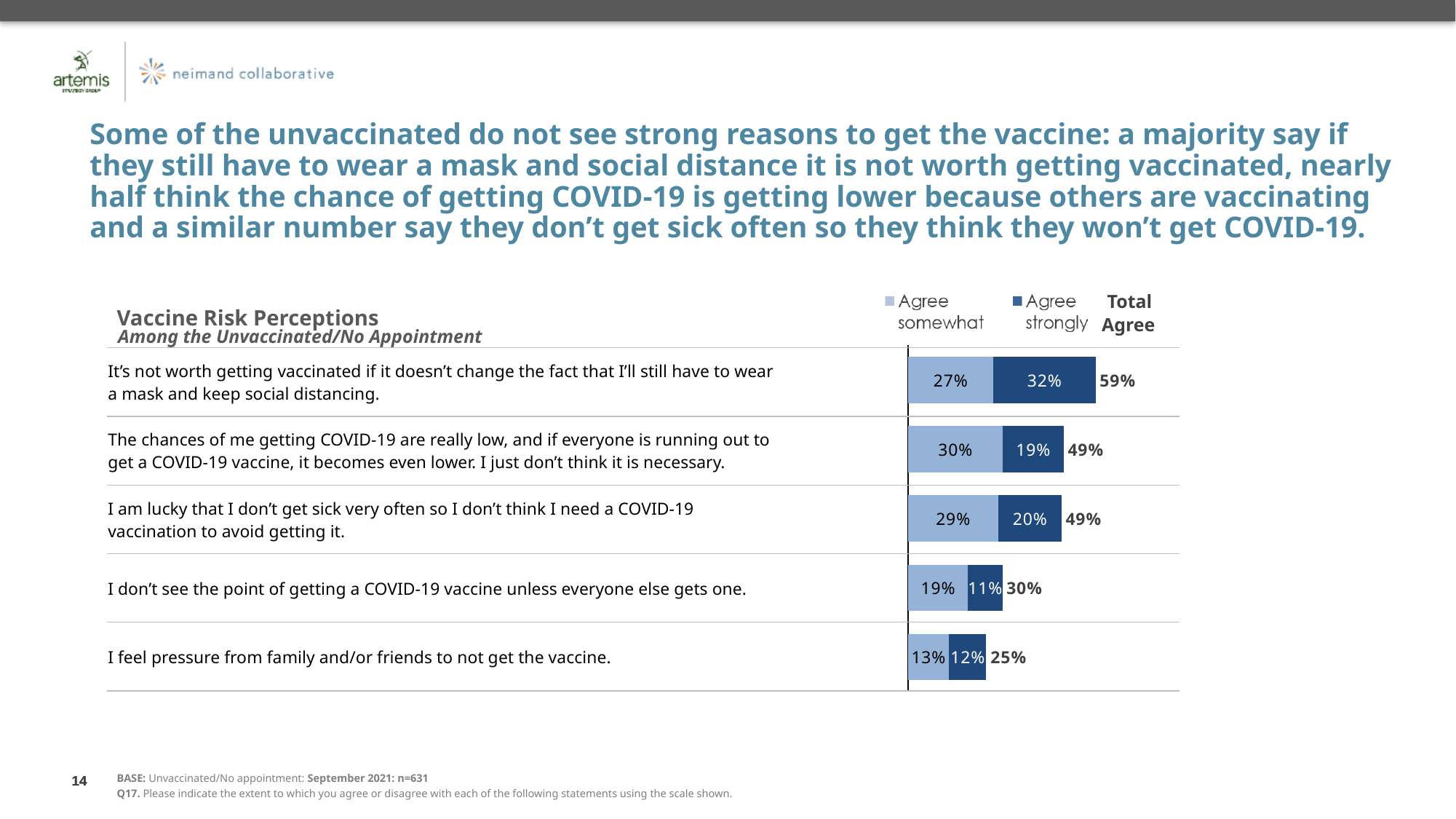
What percentage agree strongly that they don't see the point of getting a COVID-19 vaccine unless everyone else gets one? 11% What is the difference between the Total Agree for the mask/social distancing statement and the Total Agree for the 'unless everyone else gets one' statement? 29% What type of chart is shown on the slide? Stacked bar chart What is the Total Agree for the statement 'I feel pressure from family and/or friends to not get the vaccine'? 25% Which statement has the lowest Total Agree? I feel pressure from family and/or friends to not get the vaccine. What percentage agree strongly that it's not worth getting vaccinated if they still have to wear a mask and keep social distancing? 32% Which is larger: the Agree strongly share for 'I am lucky that I don't get sick very often' or the Agree strongly share for 'The chances of me getting COVID-19 are really low'? I am lucky that I don't get sick very often What percentage agree somewhat that the chances of getting COVID-19 are really low and the vaccine is not necessary? 30% What is the total of the stacked bar for 'I am lucky that I don't get sick very often so I don't think I need a COVID-19 vaccination'? 49% Which statement has the highest Total Agree? It's not worth getting vaccinated if it doesn't change the fact that I'll still have to wear a mask and keep social distancing. How many series does the legend list? 2 How many statements are shown in the chart? 5